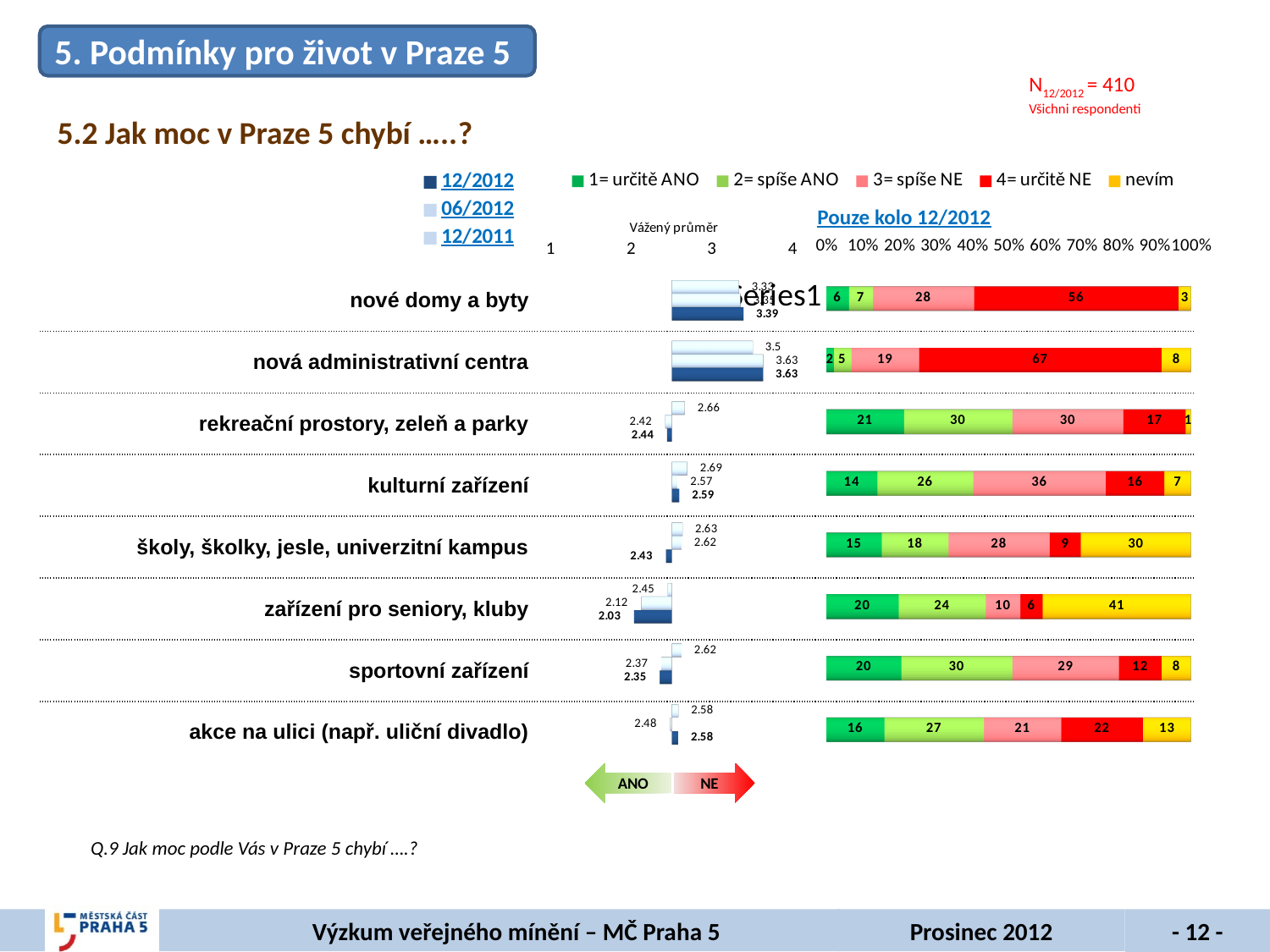
How many series does the legend of the 'Pouze kolo 12/2012' stacked bar chart list? 5 In the 'Pouze kolo 12/2012' stacked bar chart, which category has the highest '4= určitě NE' value? nová administrativní centra In the 'Pouze kolo 12/2012' stacked bar chart, what is the value of '4= určitě NE' for 'nová administrativní centra'? 67 In the 'Pouze kolo 12/2012' stacked bar chart, which category has the highest 'nevím' value? zařízení pro seniory, kluby What kind of chart is the 'Pouze kolo 12/2012' chart? Stacked bar chart How many categories are shown in the 'Pouze kolo 12/2012' stacked bar chart? 8 In the 'Pouze kolo 12/2012' stacked bar chart, what is the '1= určitě ANO' value for 'rekreační prostory, zeleň a parky'? 21 In the 'Pouze kolo 12/2012' stacked bar chart, what is the 'nevím' value for 'zařízení pro seniory, kluby'? 41 In the 'Pouze kolo 12/2012' stacked bar chart, what is the difference between the '4= určitě NE' values for 'nové domy a byty' and 'rekreační prostory, zeleň a parky'? 39 In the 'Vážený průměr' chart, which category has the lowest 12/2012 weighted average? zařízení pro seniory, kluby In the 'Vážený průměr' chart, what is the 12/2012 weighted average for 'nová administrativní centra'? 3.63 In the 'Pouze kolo 12/2012' stacked bar chart, which has the larger '2= spíše ANO' value: 'sportovní zařízení' or 'kulturní zařízení'? sportovní zařízení